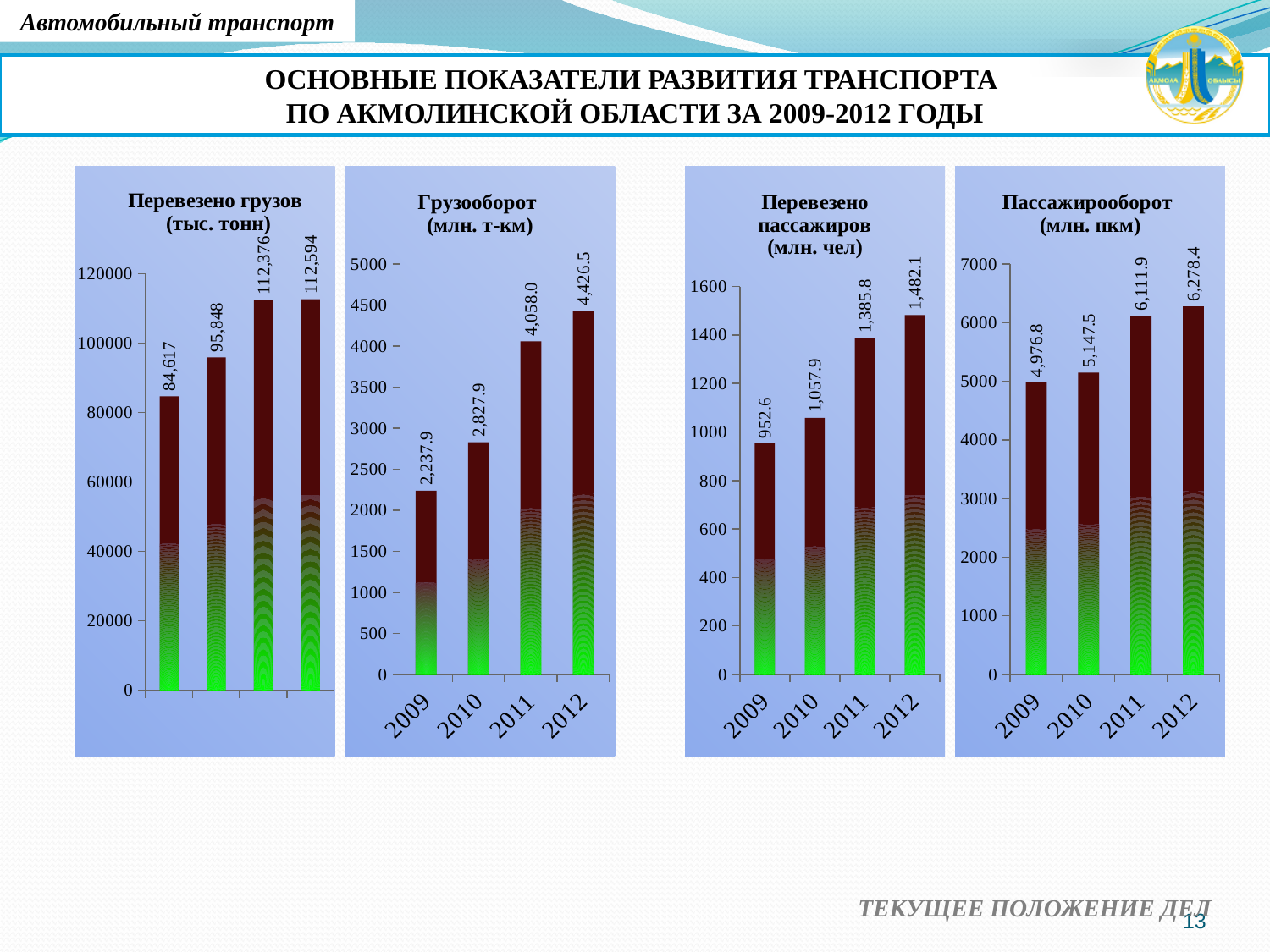
In the chart titled "Грузооборот (млн. т-км)", which year has the larger value, 2010 or 2011? 2011 In the chart titled "Перевезено пассажиров (млн. чел)", what is the difference between the 2012 and 2011 values? 96.3 What kind of chart is the one titled "Перевезено пассажиров (млн. чел)"? bar chart How many bars are plotted in the chart titled "Грузооборот (млн. т-км)"? 4 In the chart titled "Пассажирооборот (млн. пкм)", is the value for 2009 greater or less than 5000? less In the chart titled "Грузооборот (млн. т-км)", what is the value for 2011? 4,058.0 In the chart titled "Грузооборот (млн. т-км)", which year has the lowest value? 2009 In the leftmost chart titled "Перевезено грузов (тыс. тонн)", what is the highest value shown? 112,594 In the chart titled "Пассажирооборот (млн. пкм)", what is the value for 2012? 6,278.4 In the chart titled "Перевезено пассажиров (млн. чел)", what is the value for 2009? 952.6 In the chart titled "Пассажирооборот (млн. пкм)", how much higher is the 2010 value than the 2009 value? 170.7 In the chart titled "Перевезено пассажиров (млн. чел)", do the values rise or fall from 2009 to 2012? rise